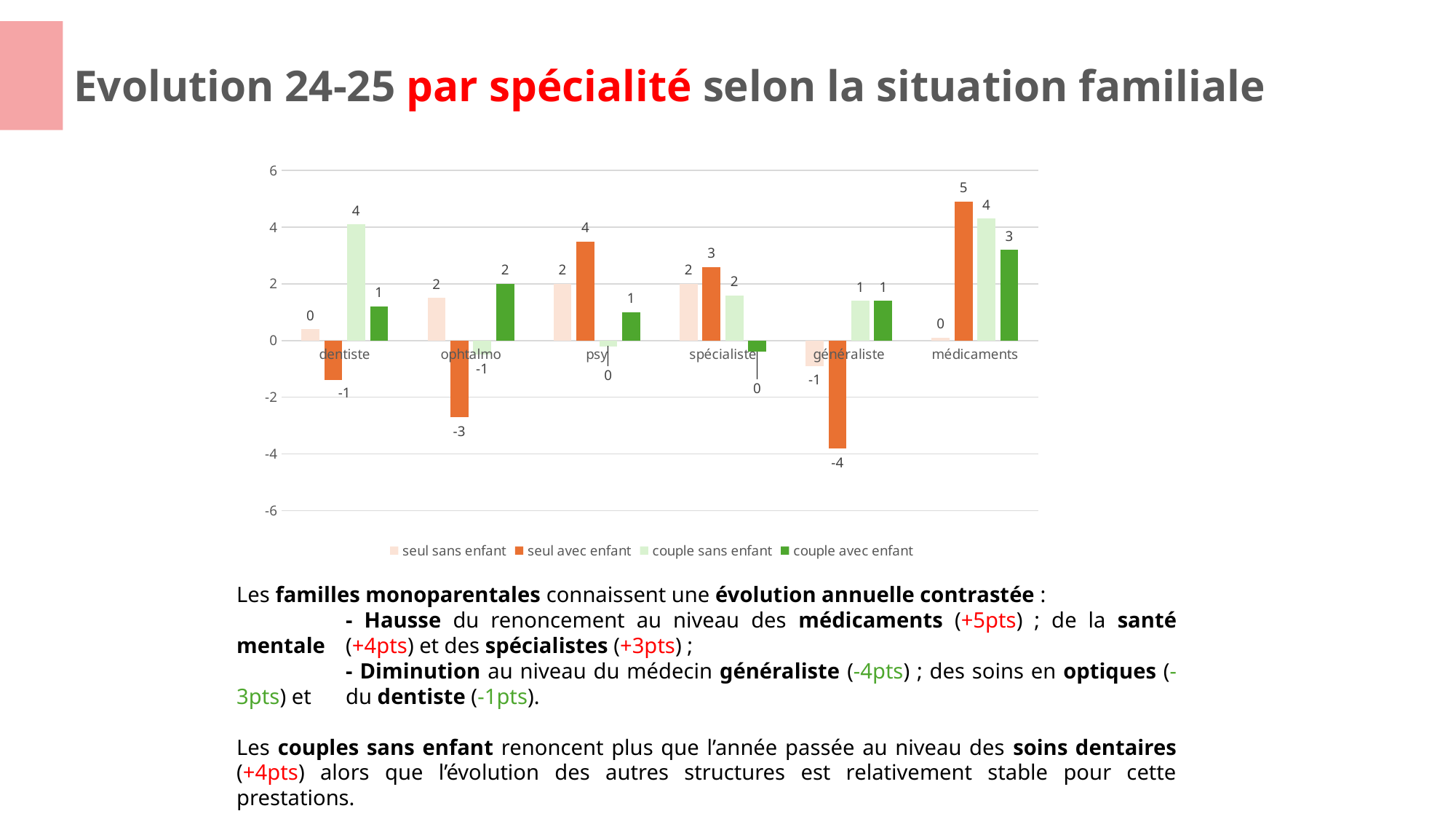
What is the value for 'couple sans enfant' in the 'dentiste' category? 4 How many series does the chart legend list? 4 In which category does the 'seul avec enfant' series reach its highest value? médicaments What is the value for 'seul avec enfant' in the 'ophtalmo' category? -3 What type of chart is shown on the slide? bar chart What is the difference between the 'seul avec enfant' value and the 'couple avec enfant' value in the 'médicaments' category? 2 What is the value for 'seul avec enfant' in the 'généraliste' category? -4 In which category does the 'seul avec enfant' series have its lowest value? généraliste What is the value for 'seul avec enfant' in the 'médicaments' category? 5 Which series is shown in dark green in the chart? couple avec enfant For 'couple sans enfant', which category has the larger value: 'dentiste' or 'ophtalmo'? dentiste How many categories are shown on the x axis of the chart? 6